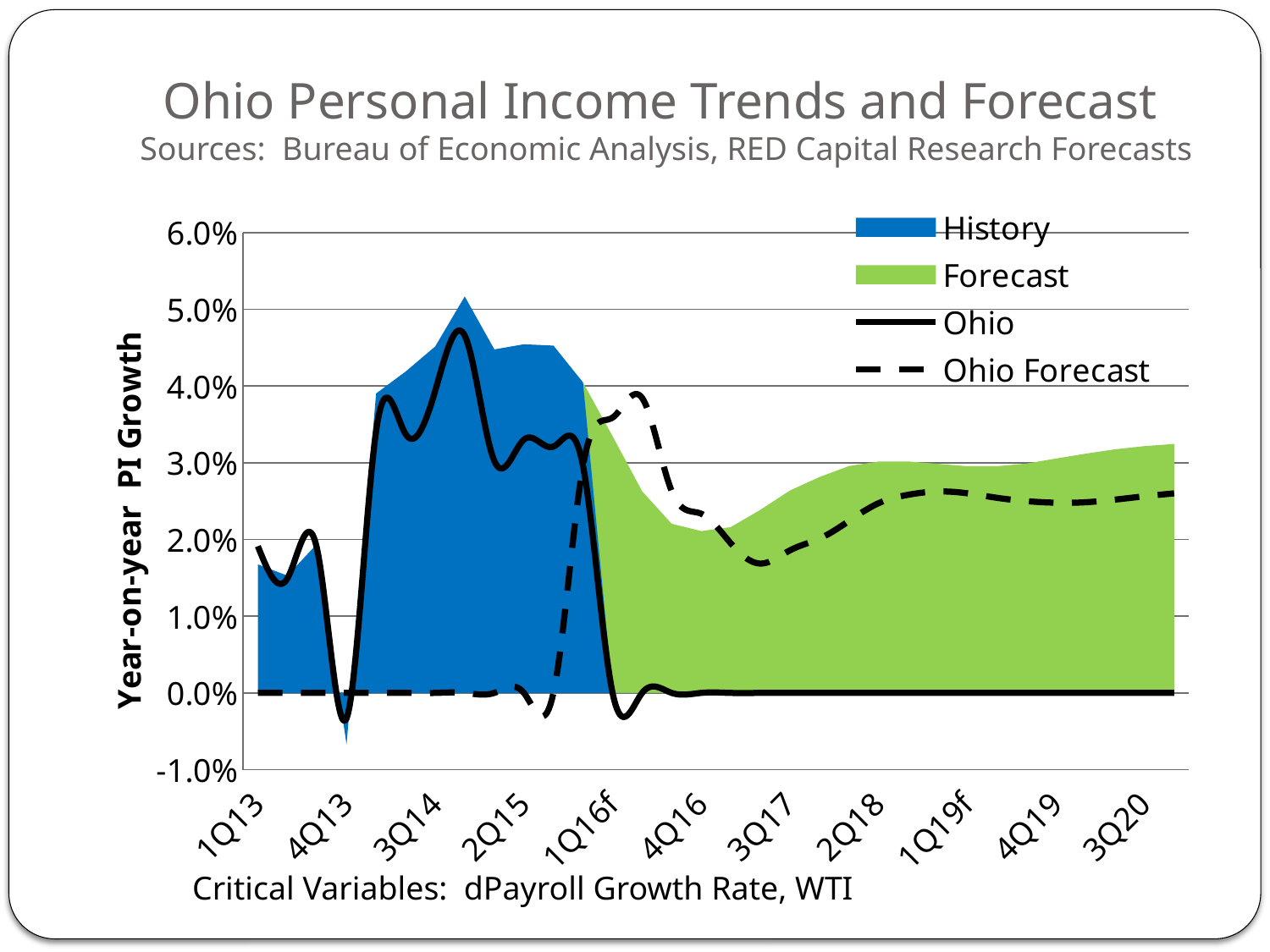
Is the value for History at 4Q13 greater or less than 0.0%? less Is the value for History at 3Q14 greater or less than 3.0%? greater Does the Ohio Forecast line rise or fall from 1Q16f to 3Q17? fall Does the Forecast area rise or fall from 4Q16 to 3Q20? rise How many labelled points are shown on the x axis? 11 How many series does the legend list? 4 What is the label on the y axis? Year-on-year PI Growth What is the title of the chart? Ohio Personal Income Trends and Forecast Is the value for Forecast at 3Q20 greater or less than 2.0%? greater What kind of chart is this? Area chart with line series